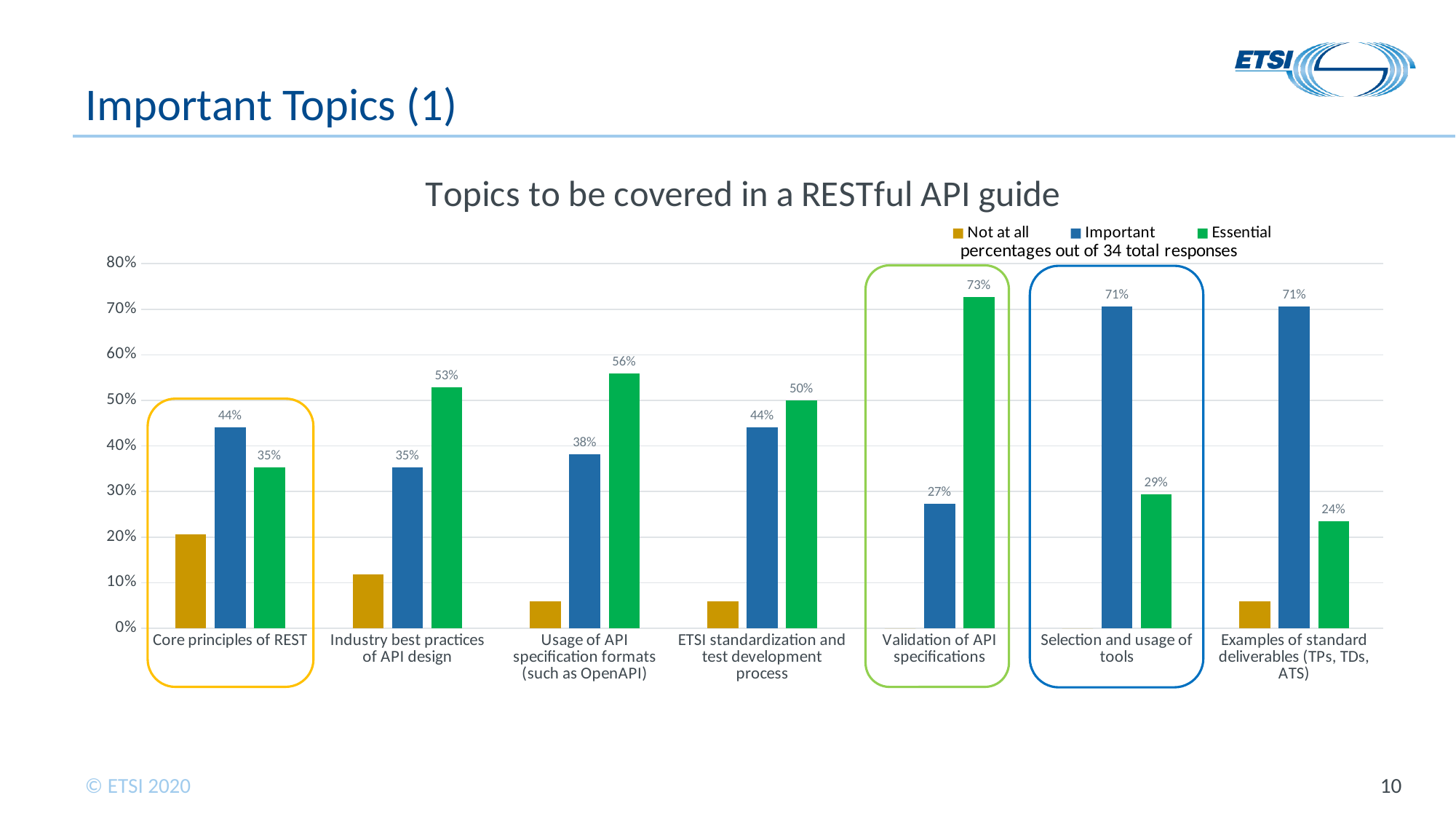
What is the title of the chart? Topics to be covered in a RESTful API guide How many series does the legend list? 3 How many topic categories are shown on the x axis? 7 What kind of chart is shown on the slide? bar chart What is the Essential value for Validation of API specifications? 73% Which is larger for Usage of API specification formats (such as OpenAPI): the Important value or the Essential value? Essential Which category has the highest Essential value? Validation of API specifications What is the difference between the Essential and Important values for Validation of API specifications? 46% Is the Not at all value for Core principles of REST greater or less than 30%? less What is the Important value for Selection and usage of tools? 71% Which category has the lowest Essential value? Examples of standard deliverables (TPs, TDs, ATS) What is the Essential value for Examples of standard deliverables (TPs, TDs, ATS)? 24%